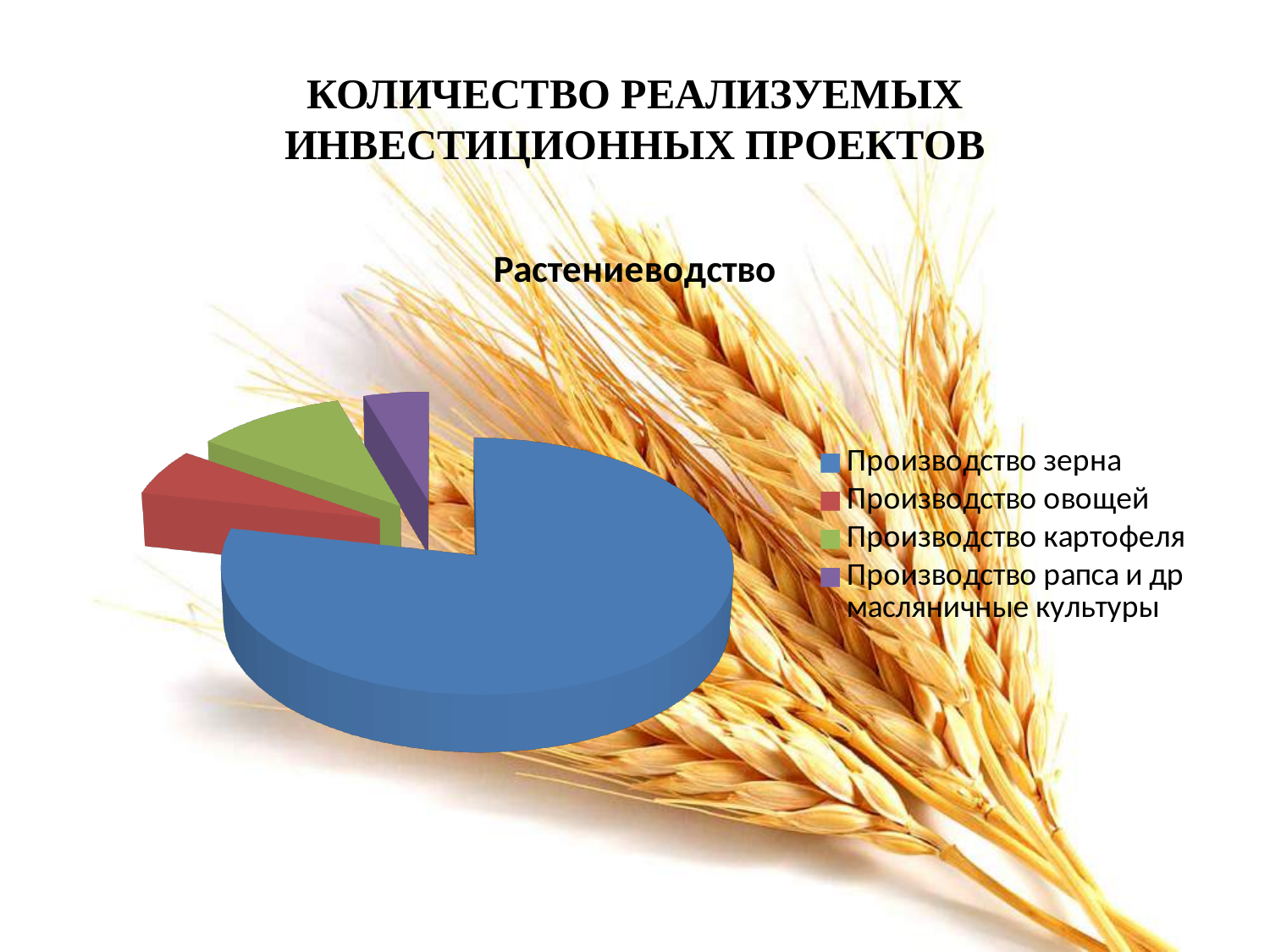
How many entries does the legend list? 4 Which slice is larger: Производство картофеля or Производство рапса и др масляничные культуры? Производство картофеля What colour is the slice for Производство зерна? Blue Which category has the smallest slice of the pie? Производство рапса и др масляничные культуры What kind of chart is shown on the slide? Pie chart Which slice is larger: Производство зерна or Производство овощей? Производство зерна Which category has the largest slice of the pie? Производство зерна How many slices does the pie chart have? 4 What is the title of the chart? Растениеводство Does Производство зерна account for more or less than half of the pie? More